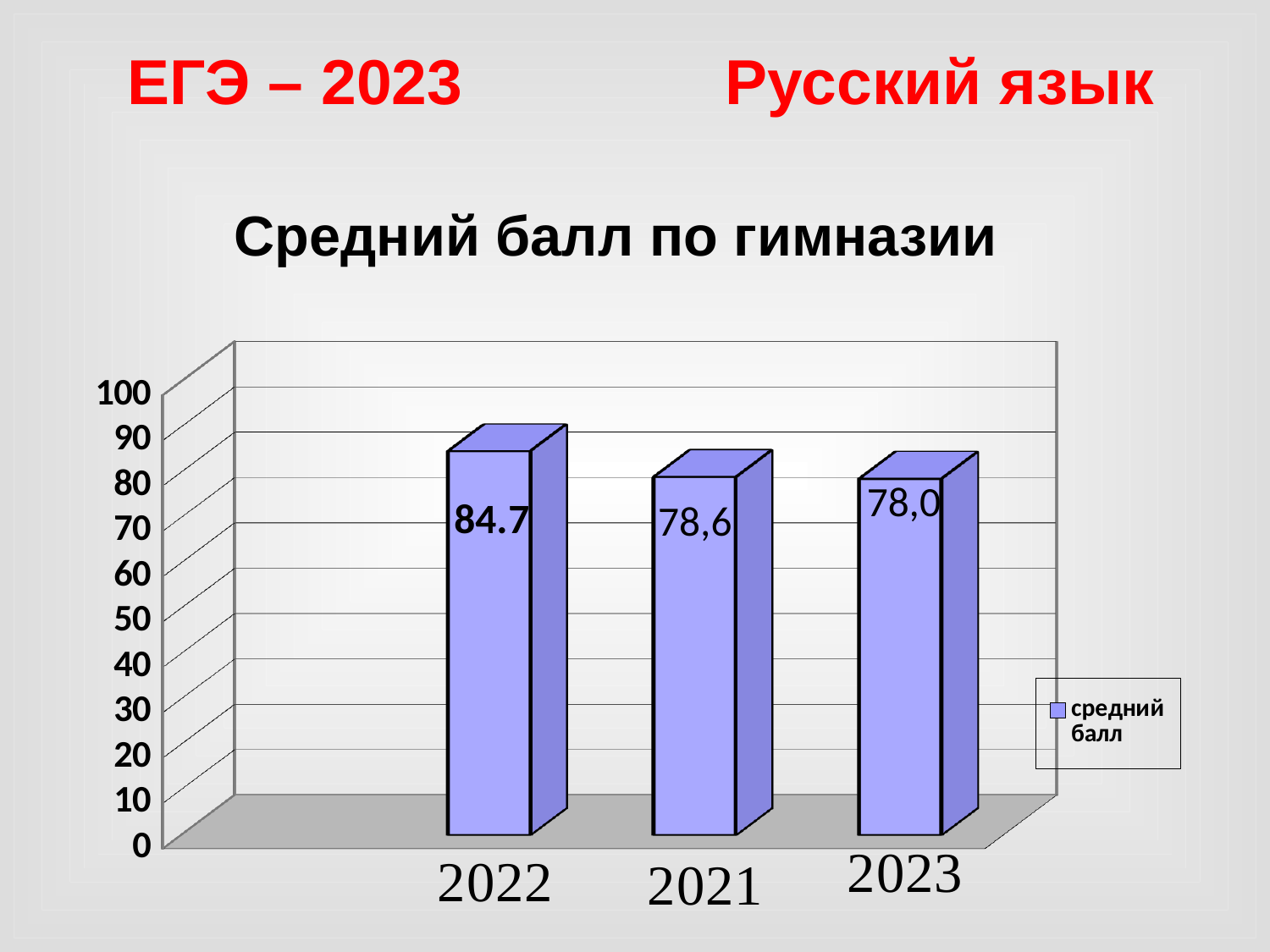
What kind of chart is shown on the slide? bar chart What is the average score shown for 2022? 84.7 Which year has the lowest average score? 2023 What is the title of the chart? Средний балл по гимназии Which is larger, the average score for 2021 or for 2023? 2021 Which year has the highest average score? 2022 What is the difference between the average scores for 2022 and 2021? 6.1 Is the value for 2022 greater or less than 80? greater What is the difference between the average scores for 2021 and 2023? 0,6 How many years are shown on the chart? 3 What is the average score shown for 2023? 78,0 What is the average score shown for 2021? 78,6